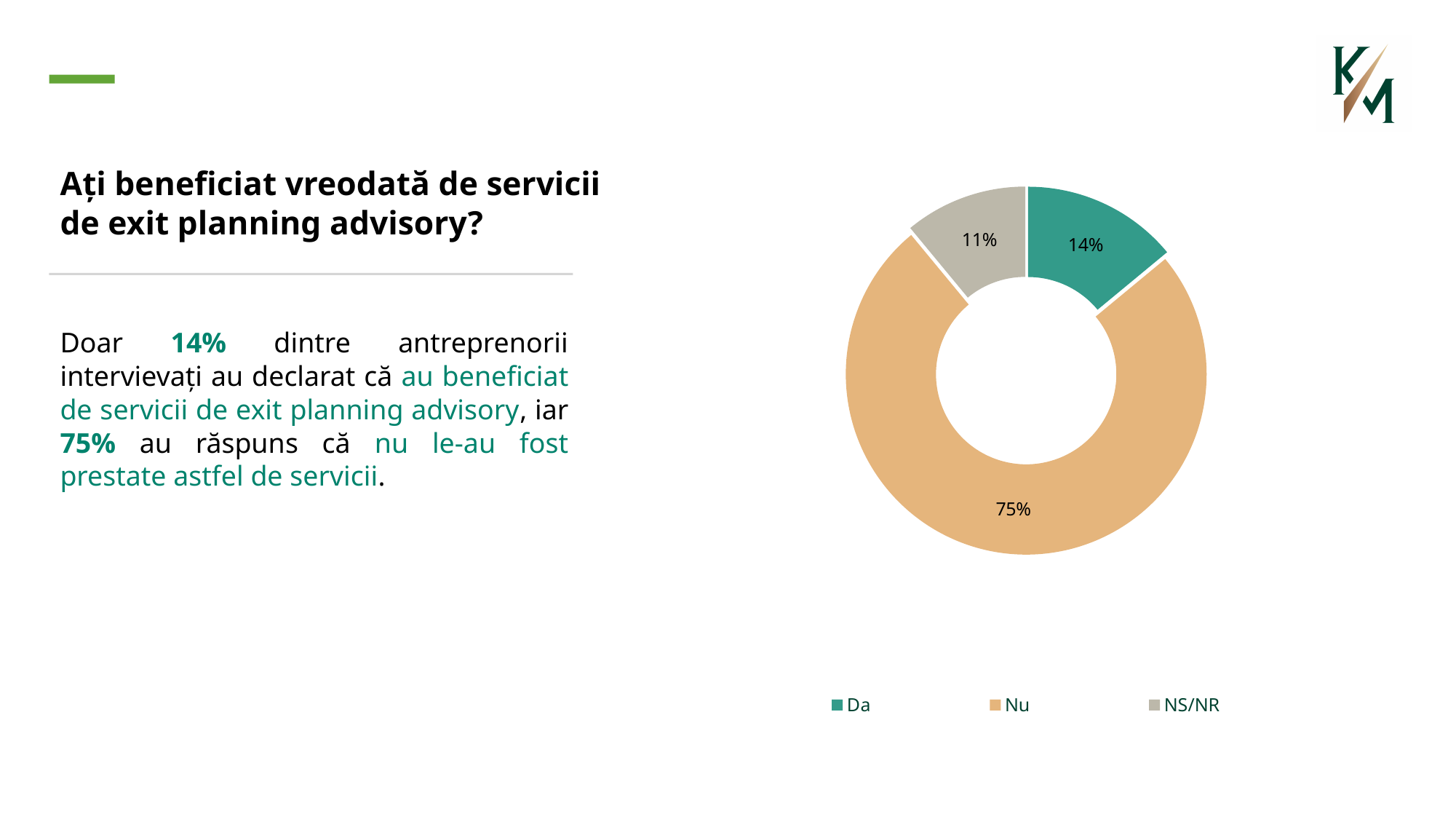
Which is larger, the share for "Da" or the share for "NS/NR"? Da What kind of chart is shown on the slide? Doughnut (pie) chart Which response category has the largest share in the chart? Nu What is the difference in percentage points between the "Da" and "NS/NR" shares? 3 percentage points What share of respondents answered "Nu" in the chart? 75% How many categories does the chart show? 3 What are the three legend entries of the chart? Da, Nu, NS/NR What share of respondents answered "Da" in the chart? 14% What is the difference in percentage points between the "Nu" and "Da" shares? 61 percentage points What colour is the "Nu" segment in the chart? Orange (tan) Which response category has the smallest share in the chart? NS/NR What share of respondents answered "NS/NR" in the chart? 11%